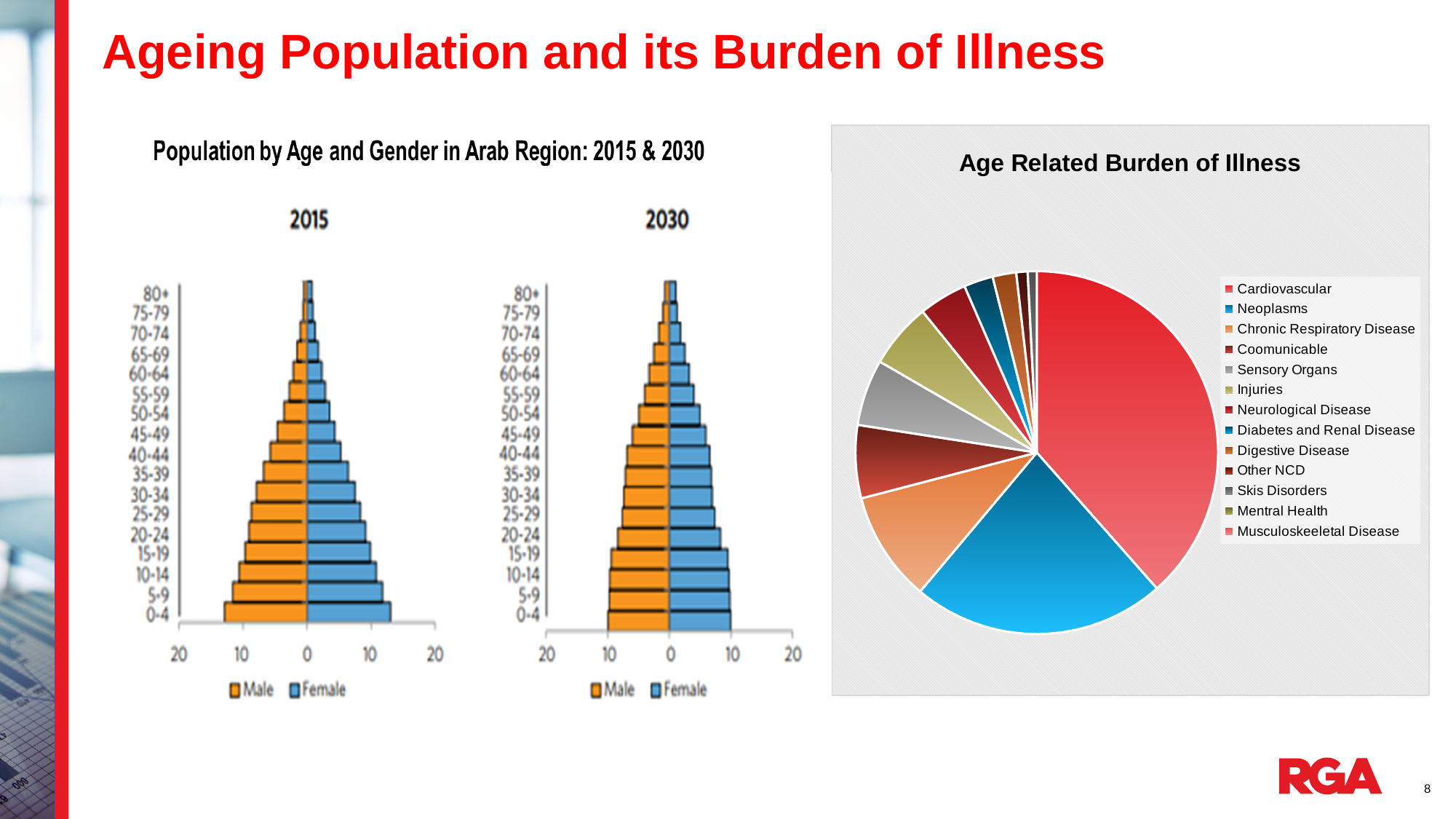
In the 2015 population pyramid, is the Female value for the 80+ age group greater or less than 10? less How many series does the legend of the 2015 population pyramid list? 2 In the 'Age Related Burden of Illness' pie chart, what colour is the Cardiovascular slice? red In the 2015 population pyramid, which colour represents Male? orange In the 2015 population pyramid, is the Male value for the 0-4 age group greater or less than 10? greater In the 'Age Related Burden of Illness' pie chart, which slice is larger, Cardiovascular or Neoplasms? Cardiovascular What kind of chart is the 'Age Related Burden of Illness' chart? pie chart In the 'Age Related Burden of Illness' pie chart, which slice is larger, Injuries or Diabetes and Renal Disease? Injuries How many age groups are shown on the 2015 population pyramid? 17 How many categories does the legend of the 'Age Related Burden of Illness' pie chart list? 13 In the 'Age Related Burden of Illness' pie chart, which slice is larger, Neoplasms or Chronic Respiratory Disease? Neoplasms In the 'Age Related Burden of Illness' pie chart, which category has the largest slice? Cardiovascular